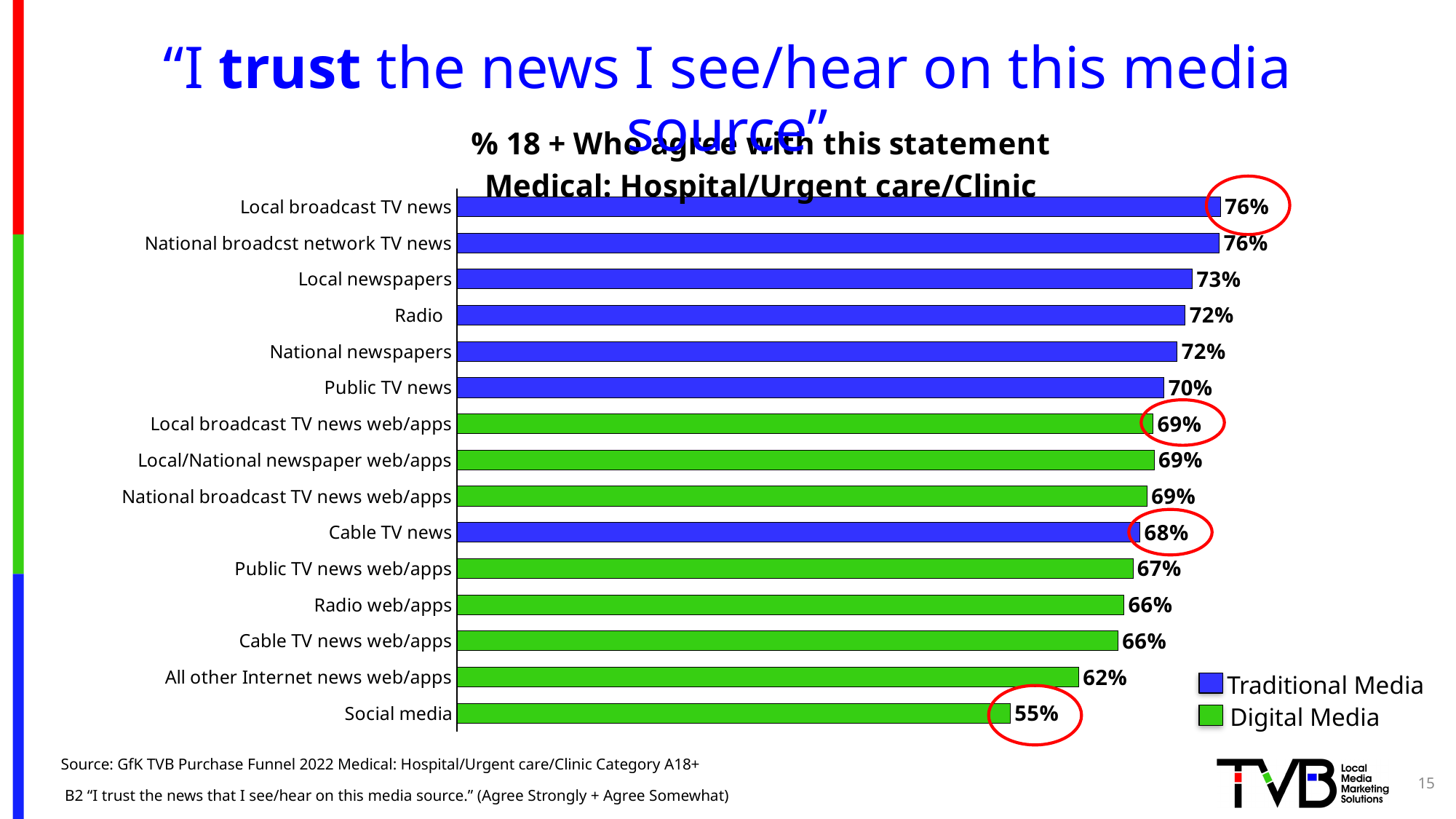
What is the difference between the values for Radio and Radio web/apps? 6% How many media sources are shown in the chart? 15 What is the value shown for Public TV news web/apps? 67% What is the difference between the values for Local broadcast TV news and Social media? 21% What is the value shown for Cable TV news? 68% How many entries does the legend list? 2 Which media source has the lowest percentage of agreement? Social media Which is larger, the value for Public TV news or the value for All other Internet news web/apps? Public TV news What kind of chart is shown on the slide? Bar chart What percentage of adults 18+ agree they trust the news on Local newspapers? 73% What is the value shown for Social media? 55% Which colour represents Digital Media in the chart? Green